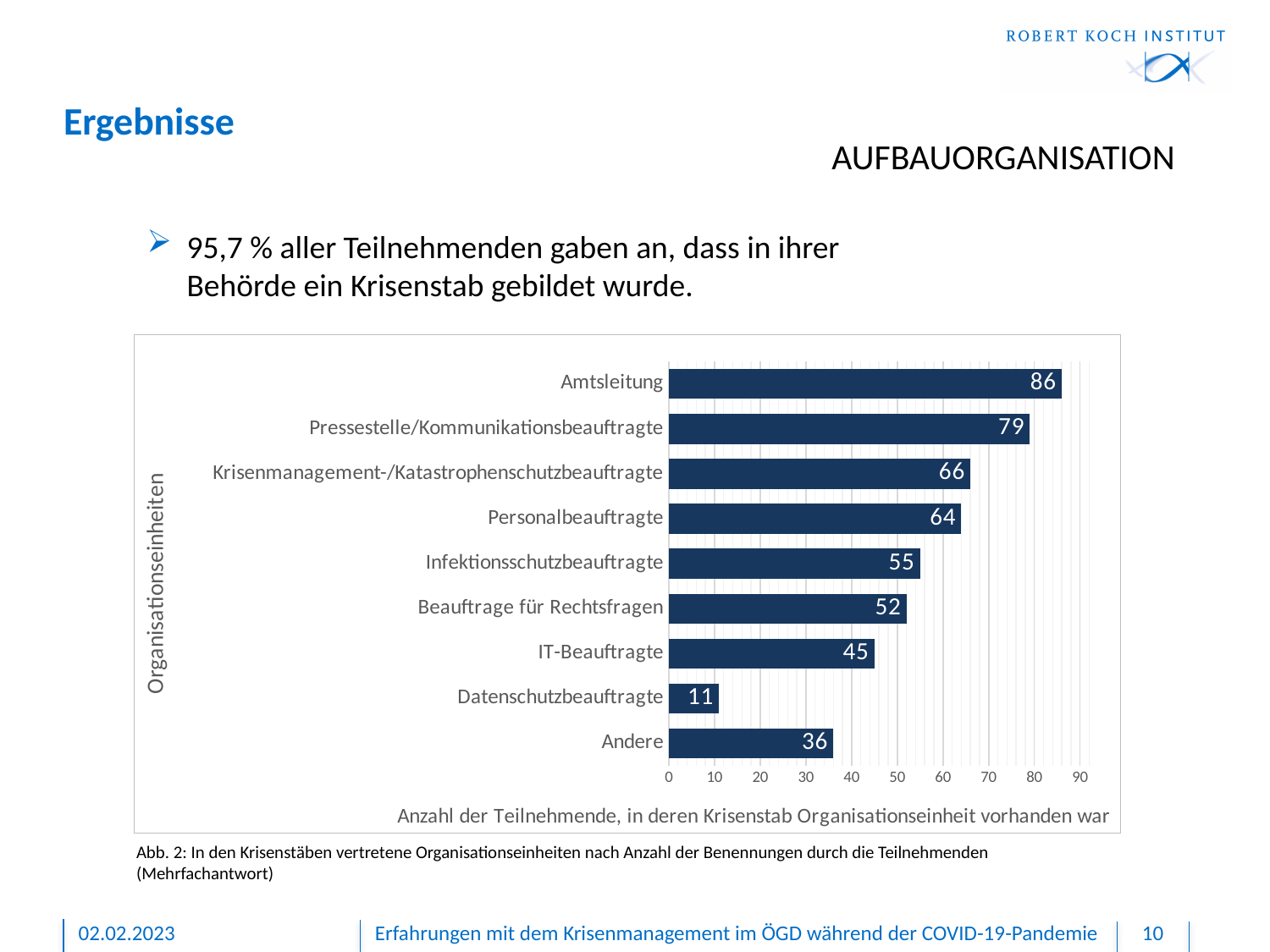
What is the label of the vertical axis of the chart? Organisationseinheiten Which category has the lowest value? Datenschutzbeauftragte Which is larger, the value for Infektionsschutzbeauftragte or the value for Beauftrage für Rechtsfragen? Infektionsschutzbeauftragte What is the difference between the values for Andere and Datenschutzbeauftragte? 25 What is the difference between the values for Amtsleitung and Pressestelle/Kommunikationsbeauftragte? 7 Which category has the highest value? Amtsleitung What is the value for Amtsleitung? 86 Is the value for Personalbeauftragte greater or less than 60? greater What is the value for Datenschutzbeauftragte? 11 What kind of chart is shown on the slide? bar chart What is the value for IT-Beauftragte? 45 How many categories are shown in the chart? 9